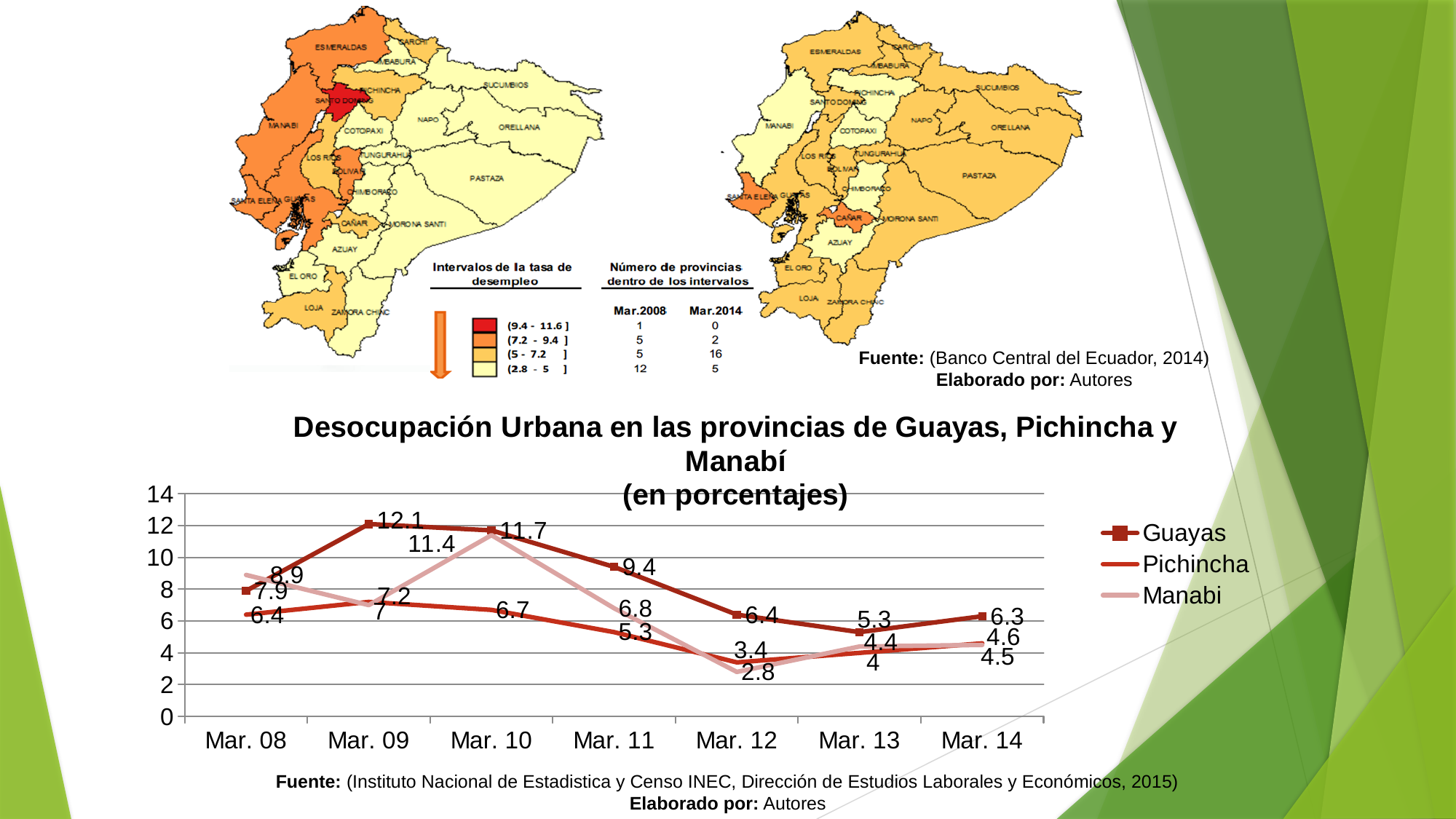
Which series is drawn with square markers in the line chart? Guayas In which period does Guayas reach its highest value? Mar. 09 How many series does the legend of the line chart list? 3 In which period does Manabi reach its lowest value? Mar. 12 What is the value for Pichincha in Mar. 12? 3.4 What is the value for Manabi in Mar. 10? 11.4 Does the Guayas series rise or fall from Mar. 09 to Mar. 13? Fall What is the difference between the Guayas and Pichincha values in Mar. 11? 4.1 How many time points are plotted along the x axis of the line chart? 7 Which series has the higher value in Mar. 08, Guayas or Manabi? Manabi What is the value for Guayas in Mar. 09? 12.1 What type of chart is shown on the slide? Line chart